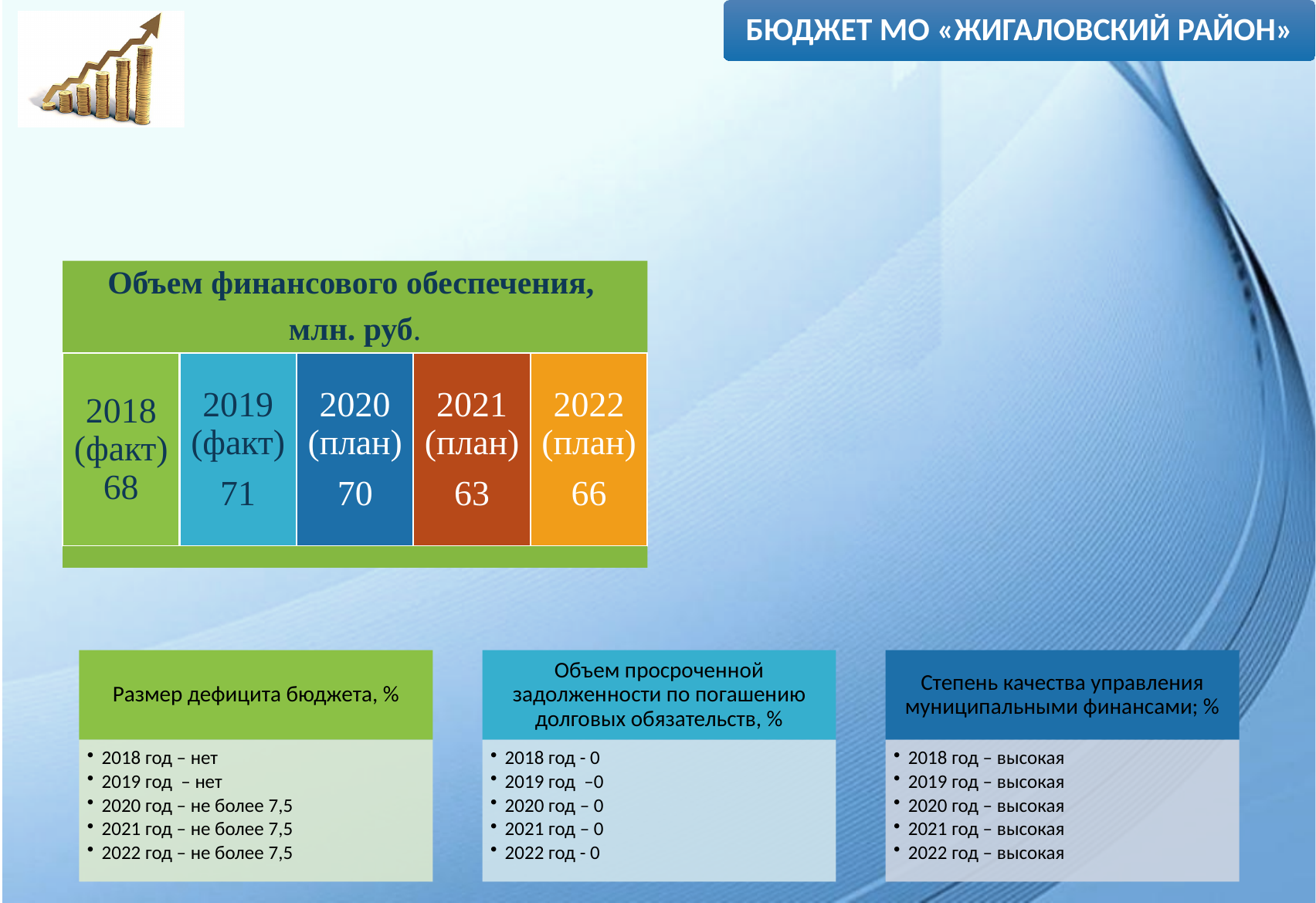
What is the planned value for 2022 in the 'Объем финансового обеспечения, млн. руб.' block? 66 Which year has the highest value in the 'Объем финансового обеспечения, млн. руб.' block? 2019 (факт) How many years are shown in the 'Объем финансового обеспечения, млн. руб.' block? 5 What is the planned value for 2020 in the 'Объем финансового обеспечения, млн. руб.' block? 70 What is the planned value for 2021 in the 'Объем финансового обеспечения, млн. руб.' block? 63 What is the value for 2019 (факт) in the 'Объем финансового обеспечения, млн. руб.' block? 71 What is the difference between the 2019 (факт) and 2021 (план) values in the 'Объем финансового обеспечения, млн. руб.' block? 8 Which year has the lowest value in the 'Объем финансового обеспечения, млн. руб.' block? 2021 (план) What is the difference between the 2020 (план) and 2018 (факт) values in the 'Объем финансового обеспечения, млн. руб.' block? 2 What unit is stated in the title of the 'Объем финансового обеспечения' block? млн. руб. In the 'Объем финансового обеспечения, млн. руб.' block, which is larger: the value for 2022 (план) or 2021 (план)? 2022 (план) What is the value for 2018 (факт) in the 'Объем финансового обеспечения, млн. руб.' block? 68